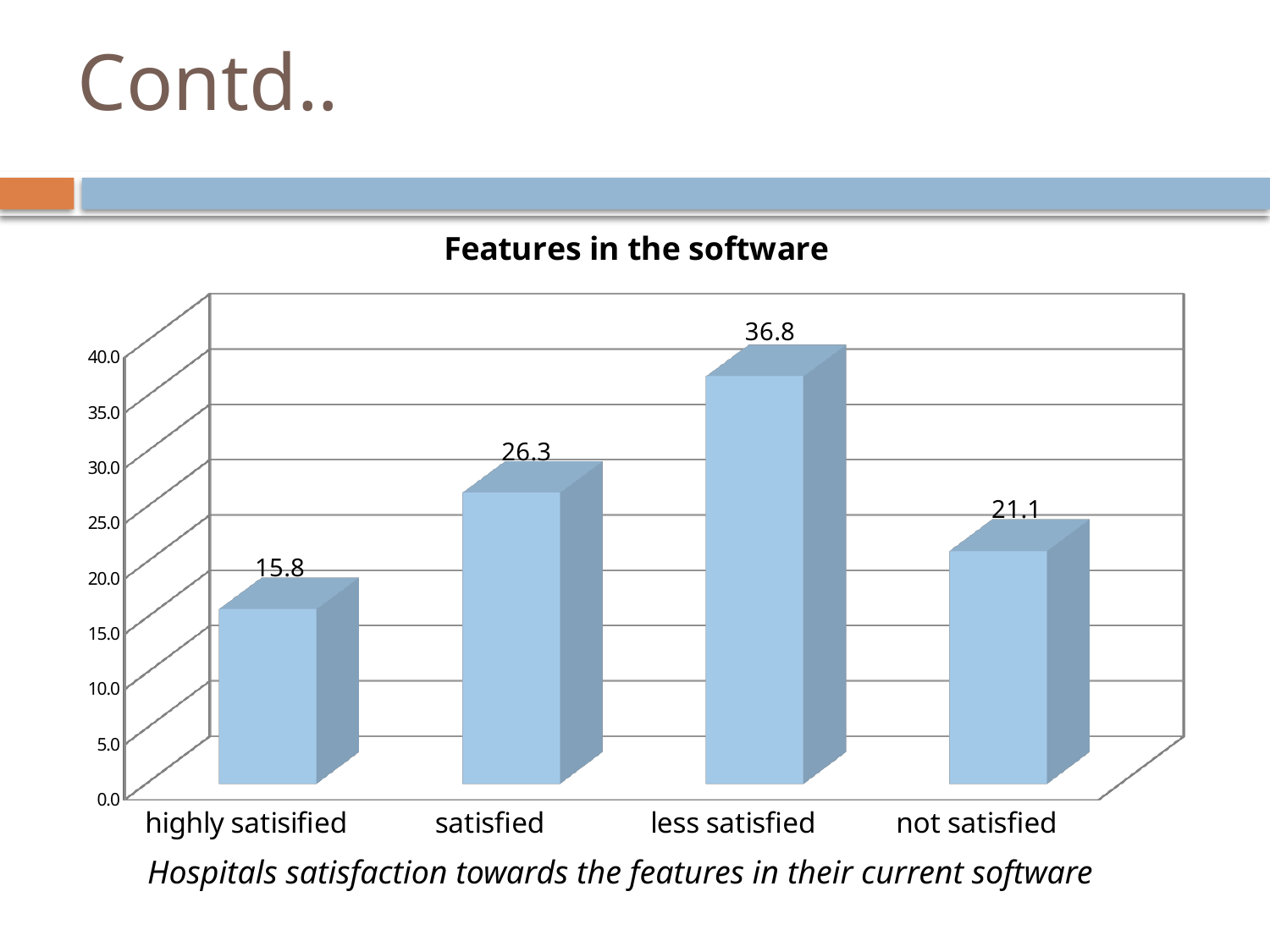
What is the difference between the values for "less satisfied" and "satisfied"? 10.5 Which category has the highest value? less satisfied What is the value for "not satisfied"? 21.1 What is the title of the chart? Features in the software Which is larger, the value for "satisfied" or the value for "not satisfied"? satisfied Which category has the lowest value? highly satisified What is the value for "highly satisified"? 15.8 What is the value for "less satisfied"? 36.8 Is the value for "not satisfied" greater or less than 25.0? less How many categories are shown on the x axis? 4 What is the value for "satisfied"? 26.3 What kind of chart is shown on the slide? bar chart